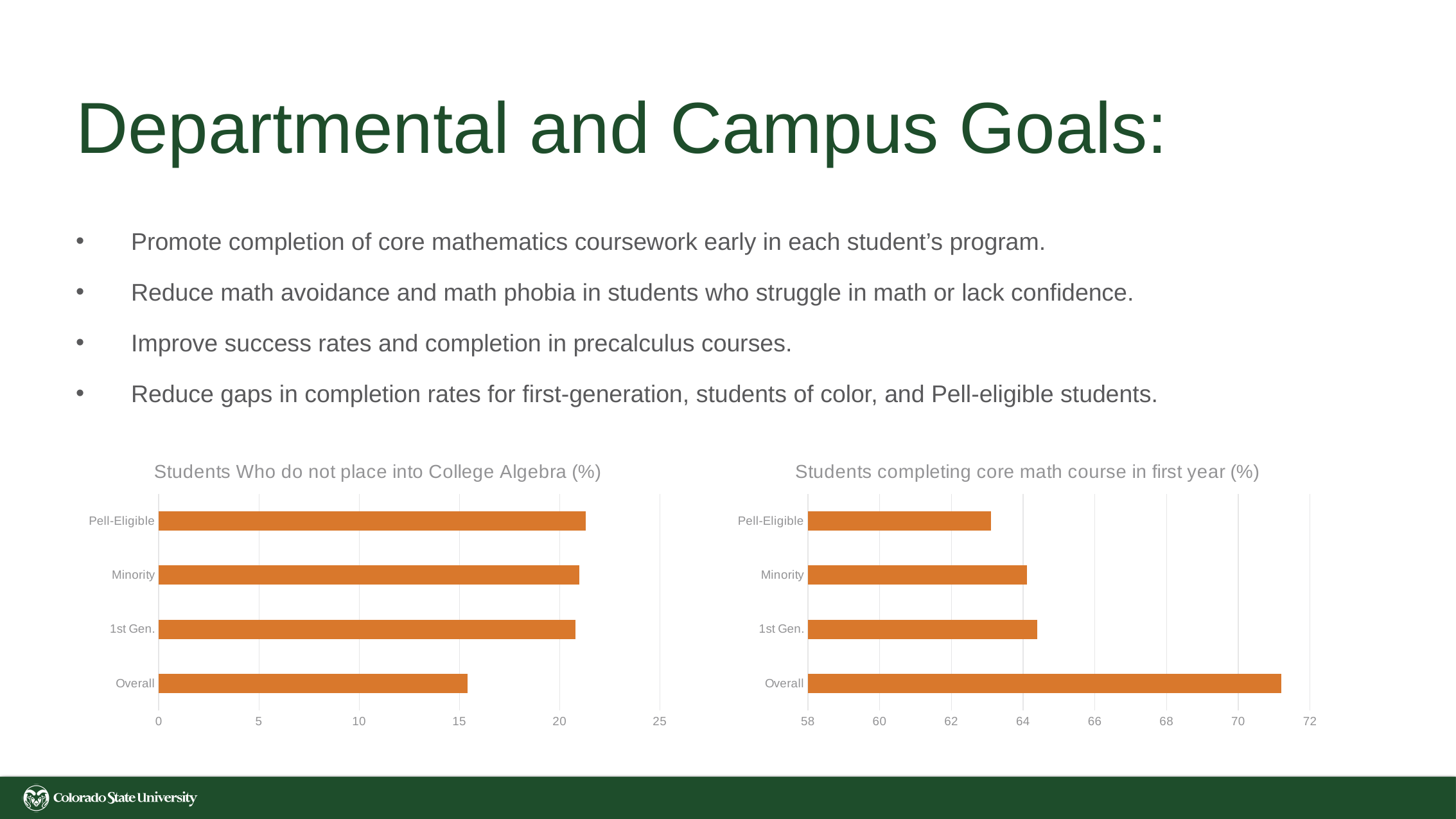
What is the title of the chart on the right side of the slide? Students completing core math course in first year (%) How many categories are shown in the 'Students completing core math course in first year (%)' chart? 4 In the 'Students completing core math course in first year (%)' chart, is the value for Pell-Eligible greater or less than 64? less In the 'Students completing core math course in first year (%)' chart, which category has the lowest value? Pell-Eligible In the 'Students completing core math course in first year (%)' chart, is the value for Overall greater or less than 70? greater In the 'Students completing core math course in first year (%)' chart, which is larger, the value for Overall or the value for Minority? Overall In the 'Students Who do not place into College Algebra (%)' chart, which category has the lowest value? Overall In the 'Students completing core math course in first year (%)' chart, which category has the highest value? Overall In the 'Students Who do not place into College Algebra (%)' chart, is the value for Pell-Eligible greater or less than 20? greater In the 'Students Who do not place into College Algebra (%)' chart, which is larger, the value for Pell-Eligible or the value for Overall? Pell-Eligible What kind of chart is the 'Students Who do not place into College Algebra (%)' chart? bar chart